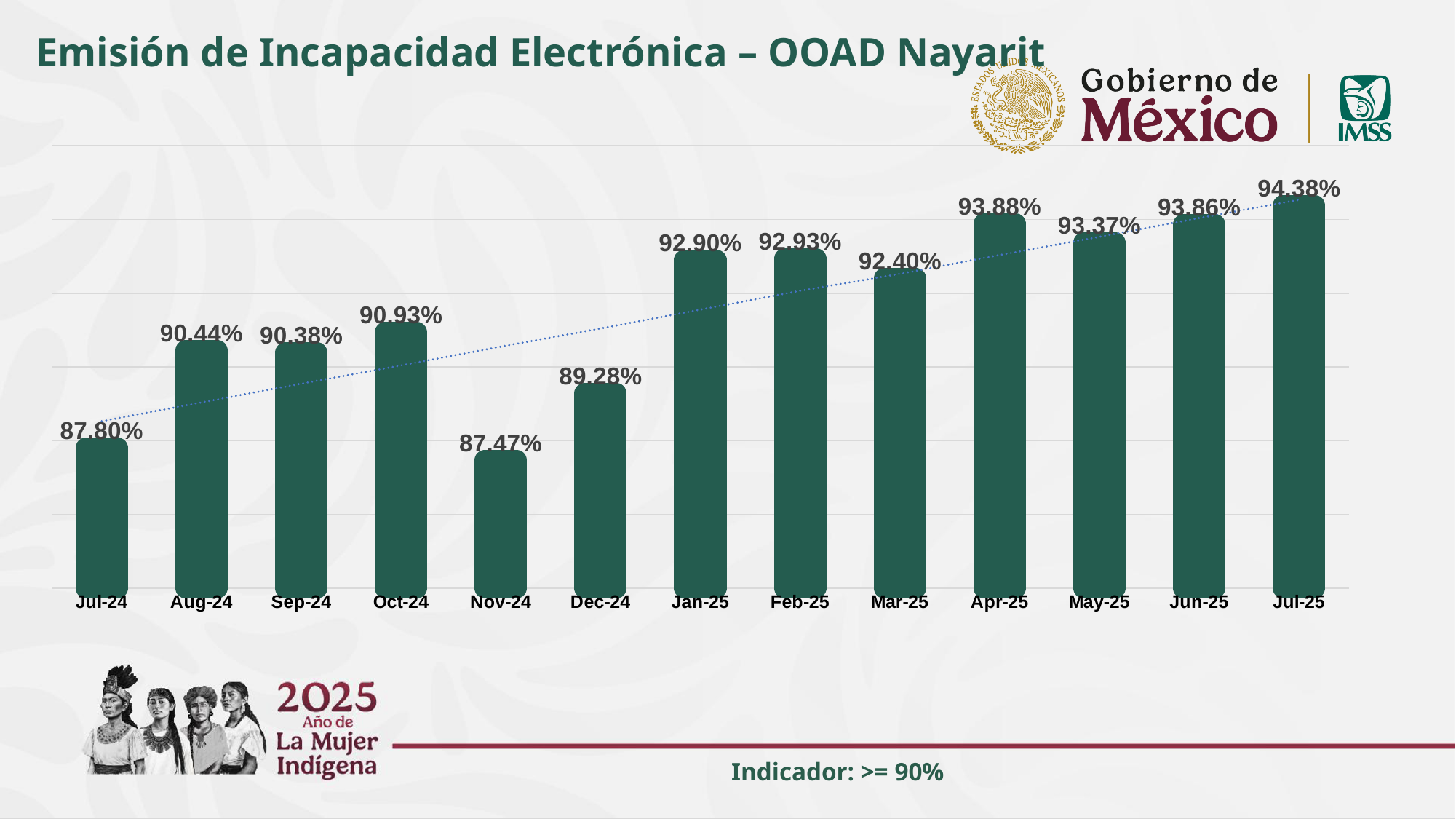
What is the value for Dec-24? 89.28% What is the value for Mar-25? 92.40% Which is larger, the value for Oct-24 or the value for Dec-24? Oct-24 What is the difference between the values for Oct-24 and Nov-24? 3.46 percentage points Do the values generally rise or fall from Jul-24 to Jul-25? Rise What is the value for Jul-24? 87.80% What is the difference between the values for Jul-25 and Jul-24? 6.58 percentage points Which month has the highest value? Jul-25 What is the title of the chart? Emisión de Incapacidad Electrónica – OOAD Nayarit What kind of chart is shown on the slide? Bar chart Which month has the lowest value? Nov-24 How many months are shown on the x axis? 13